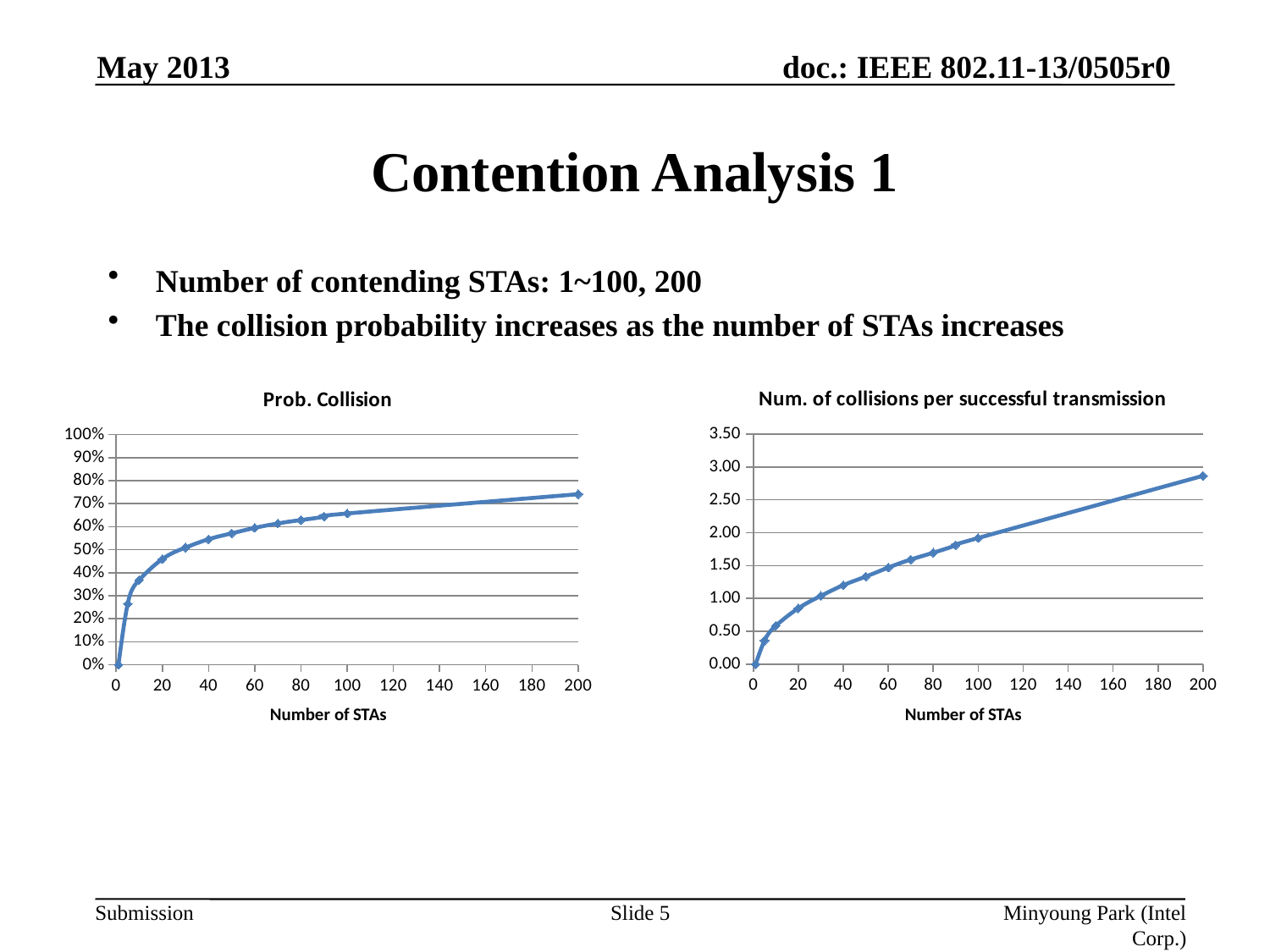
In the 'Num. of collisions per successful transmission' chart, do the values rise or fall as the number of STAs increases? rise In the 'Num. of collisions per successful transmission' chart, is the value at 200 STAs greater or less than 2.50? greater In the 'Num. of collisions per successful transmission' chart, is the value at 20 STAs greater or less than 0.50? greater What kind of chart is the 'Num. of collisions per successful transmission' chart? line chart In the 'Prob. Collision' chart, at which number of STAs is the plotted value highest? 200 In the 'Prob. Collision' chart, do the values rise or fall as the number of STAs increases? rise What kind of chart is the 'Prob. Collision' chart? line chart What is the x-axis label of the 'Num. of collisions per successful transmission' chart? Number of STAs In the 'Prob. Collision' chart, is the value at 100 STAs greater or less than 60%? greater